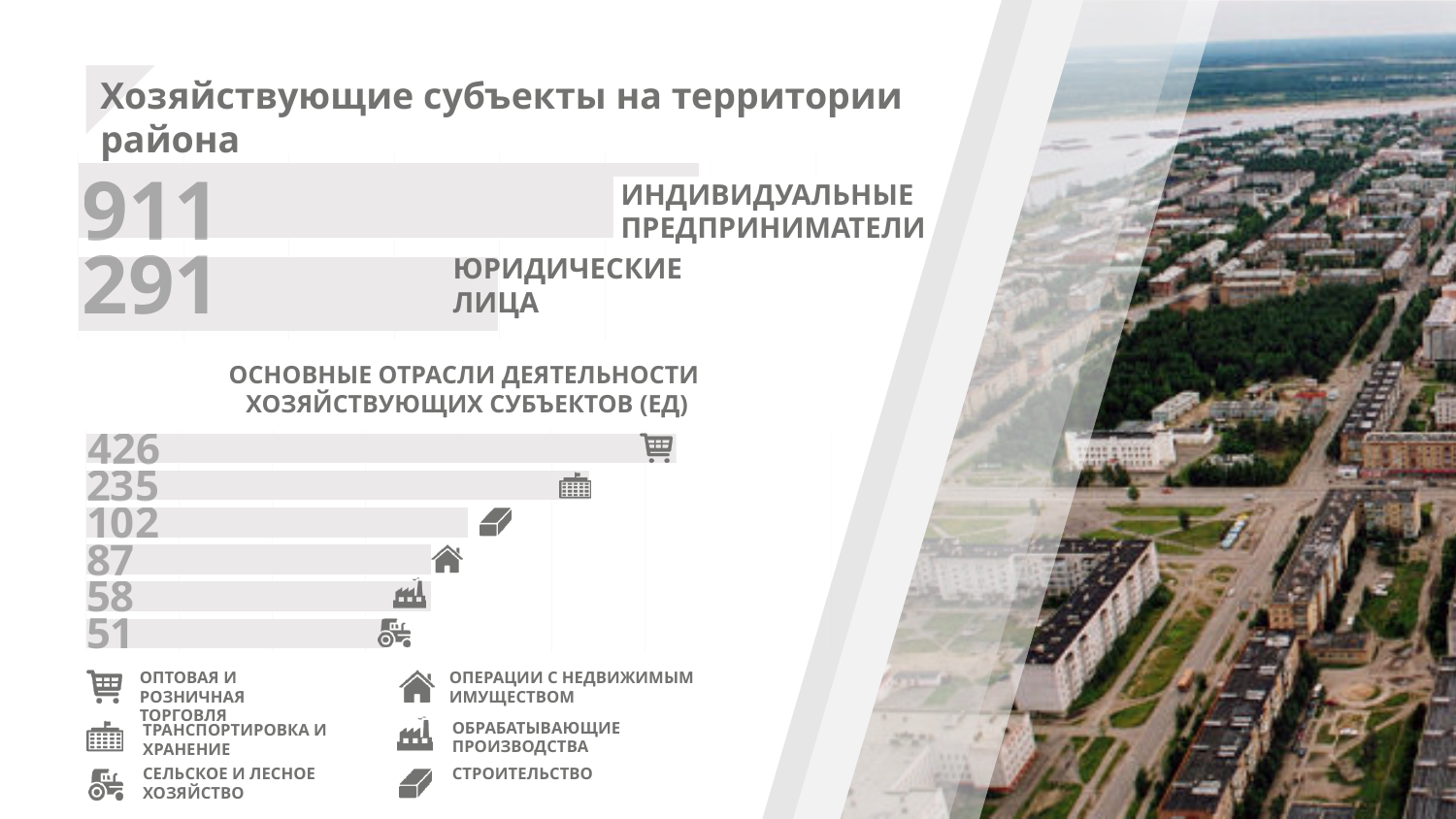
What type of chart is used to show the main industries of business entities (Основные отрасли деятельности хозяйствующих субъектов)? Bar chart How many industry categories are shown in the chart 'Основные отрасли деятельности хозяйствующих субъектов (ед)'? 6 In the industries chart, what is the value for Транспортировка и хранение (transportation and storage)? 235 In the industries chart, what is the value for Оптовая и розничная торговля (wholesale and retail trade)? 426 According to the slide, how many individual entrepreneurs (Индивидуальные предприниматели) are there in the district? 911 Which industry has the highest number of business entities in the chart? Оптовая и розничная торговля In the industries chart, what is the value for Сельское и лесное хозяйство (agriculture and forestry)? 51 In the industries chart, what is the value for Строительство (construction)? 102 In the industries chart, what is the value for Операции с недвижимым имуществом (real estate operations)? 87 In the industries chart, which is larger: Обрабатывающие производства or Операции с недвижимым имуществом? Операции с недвижимым имуществом Which industry has the lowest number of business entities in the chart? Сельское и лесное хозяйство What is the difference between the values for Оптовая и розничная торговля and Транспортировка и хранение in the industries chart? 191